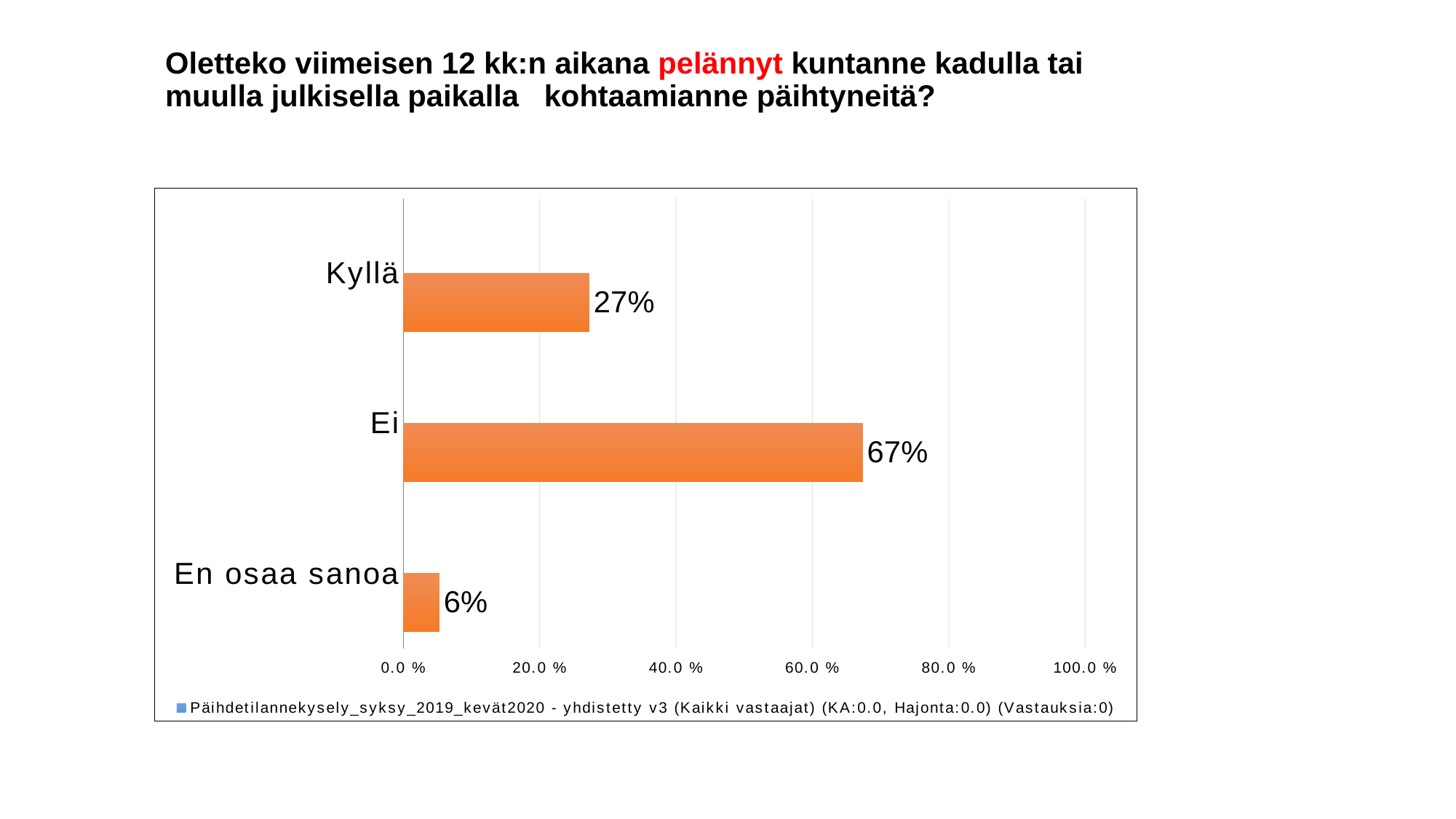
Which category has the lowest value? En osaa sanoa Is the value for Ei greater or less than 60.0 %? greater What is the difference between the values for Ei and Kyllä? 40% What is the value for En osaa sanoa? 6% What is the value for Ei? 67% How many series does the legend list? 1 What is the difference between the values for Kyllä and En osaa sanoa? 21% What kind of chart is shown on the slide? Bar chart How many categories are shown in the chart? 3 What is the value for Kyllä? 27% Which is larger, the value for Kyllä or the value for Ei? Ei Which category has the highest value? Ei